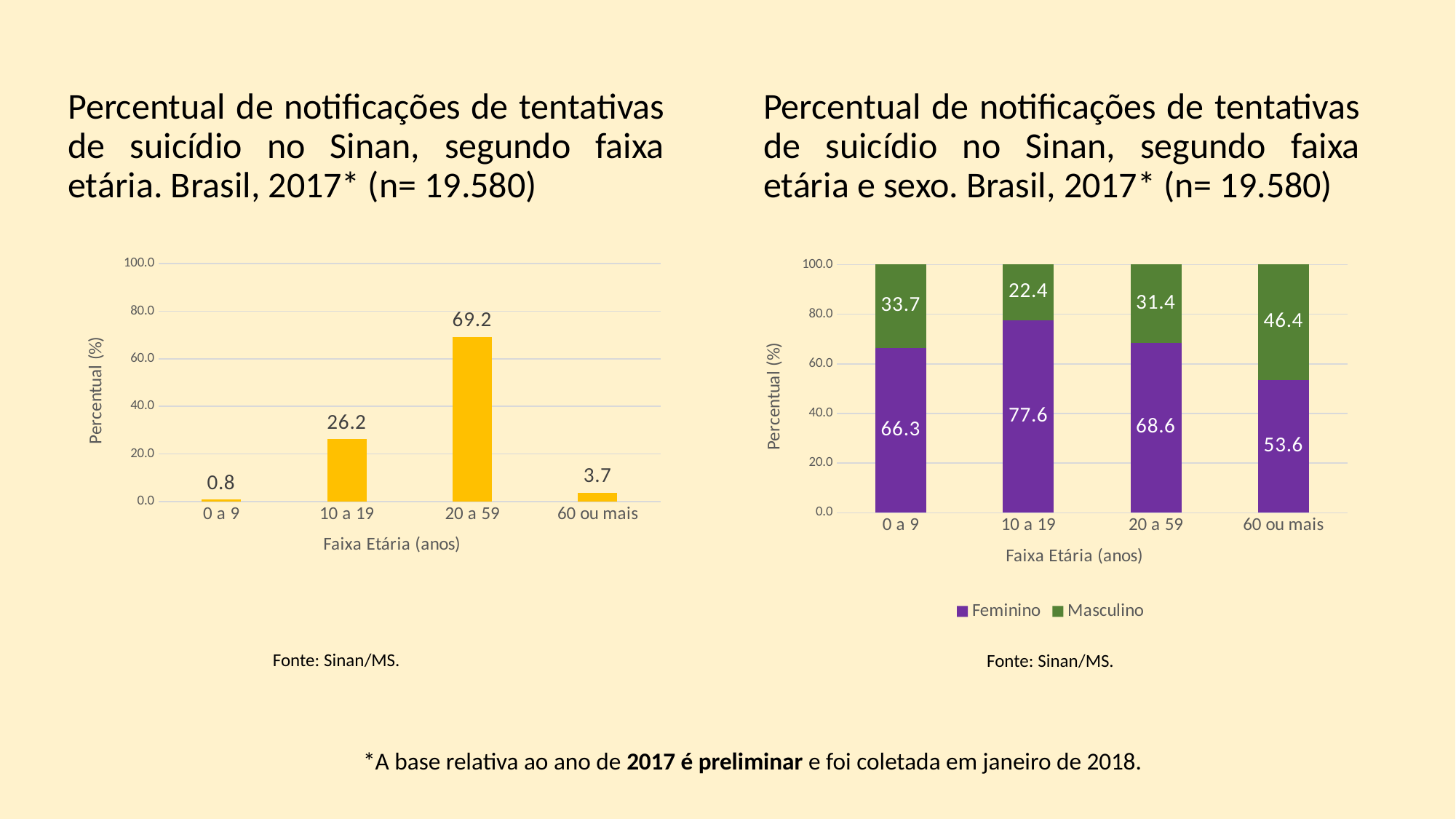
In the right chart (by age group and sex), is the Feminino value for 0 a 9 larger or the Feminino value for 20 a 59? 20 a 59 In the left chart (by age group), what is the value for the 20 a 59 age group? 69.2 In the left chart (by age group), which age group has the highest percentage? 20 a 59 In the left chart (by age group), what kind of chart is it? Bar chart In the right chart (by age group and sex), what colour represents Feminino? Purple In the left chart (by age group), how many age groups are shown? 4 In the right chart (by age group and sex), how many series does the legend list? 2 In the left chart (by age group), which age group has the lowest percentage? 0 a 9 In the right chart (by age group and sex), what is the Masculino value for 60 ou mais? 46.4 In the right chart (by age group and sex), what is the Feminino value for 10 a 19? 77.6 In the left chart (by age group), what is the difference between the values for 10 a 19 and 60 ou mais? 22.5 In the right chart (by age group and sex), which age group has the highest Masculino share? 60 ou mais